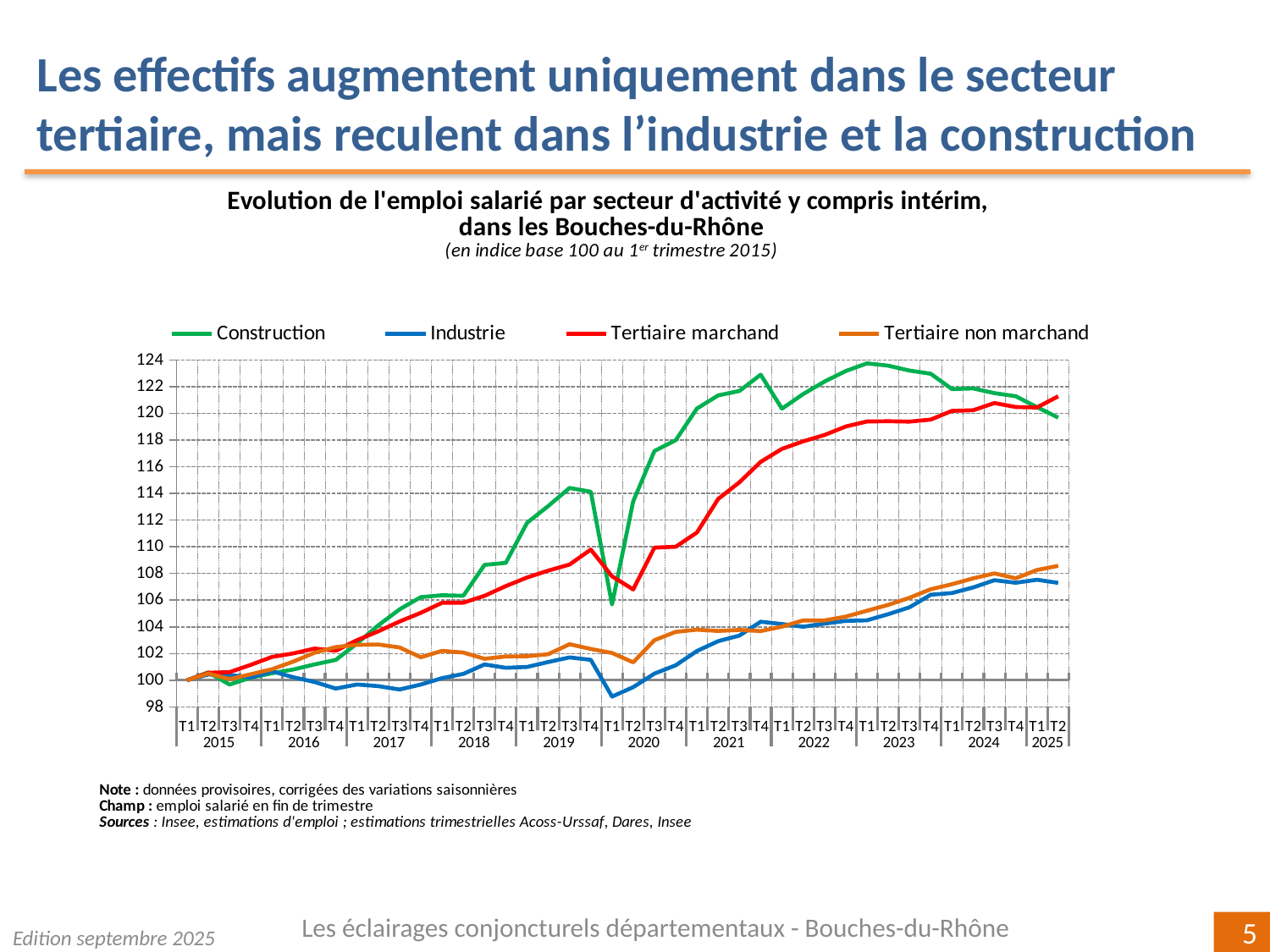
Does the Industrie series rise or fall between T1 2021 and T2 2025? rise What is the index value of all four series at T1 2015? 100 Is the value for Industrie at T1 2020 greater or less than 100? less How many series does the legend list? 4 Which series has the lowest value at T1 2020? Industrie How many years are labelled on the x axis? 11 Which series is plotted in green? Construction Which series has the highest value at T1 2023? Construction At T2 2025, which is higher: Tertiaire marchand or Construction? Tertiaire marchand What kind of chart is shown on the slide? line chart Is the value for Tertiaire marchand at T2 2025 greater or less than 120? greater Is the value for Construction at T1 2023 greater or less than 122? greater